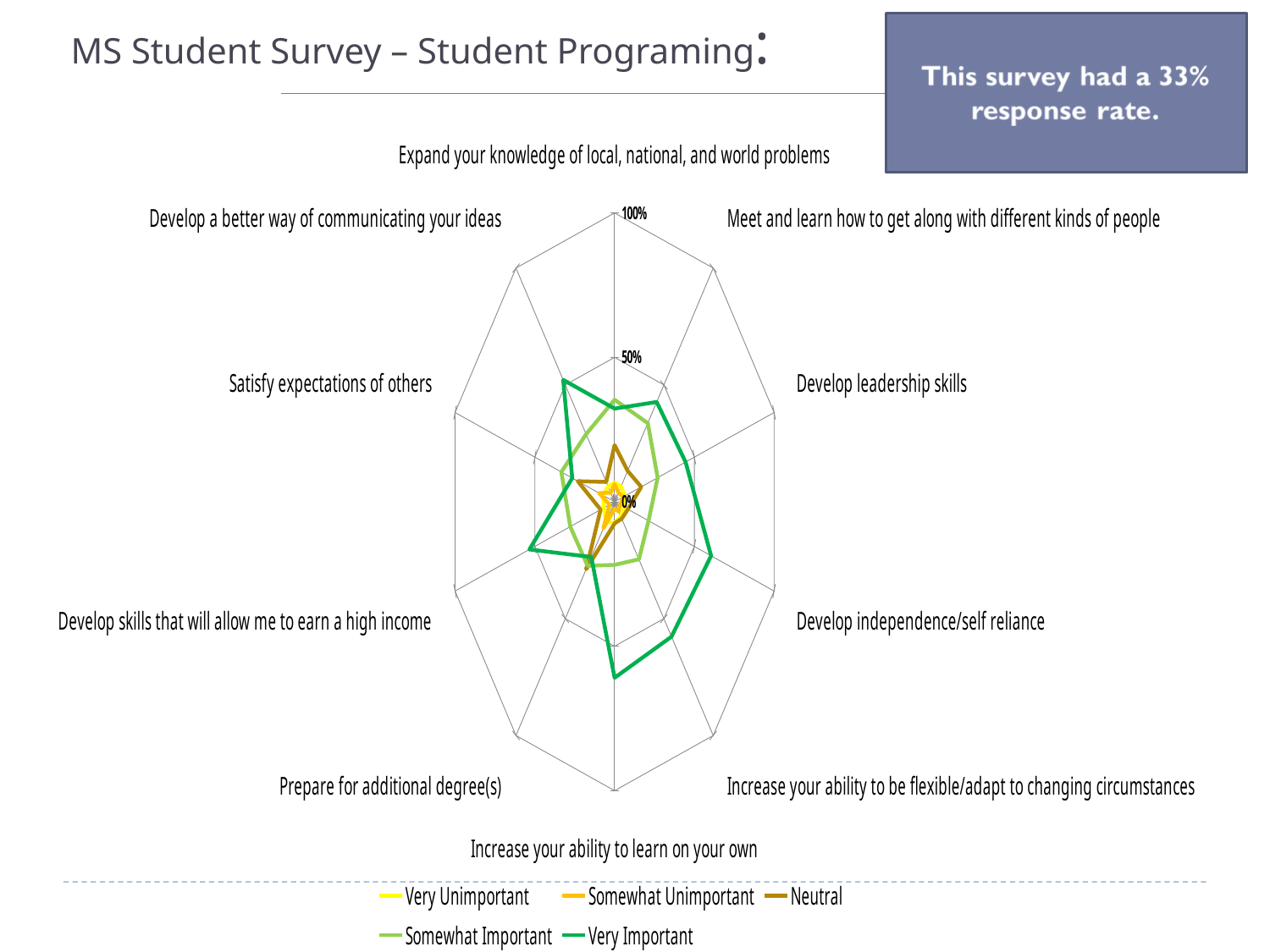
Is the Very Important value for "Increase your ability to learn on your own" greater or less than 50%? greater Is the Neutral value for "Expand your knowledge of local, national, and world problems" greater or less than 50%? less For the Very Important series, which is larger: "Increase your ability to learn on your own" or "Expand your knowledge of local, national, and world problems"? Increase your ability to learn on your own Is the Very Important value for "Expand your knowledge of local, national, and world problems" greater or less than 50%? less What kind of chart is shown on the slide? Radar chart How many categories (axes) does the radar chart have? 10 Which series is drawn in dark green on the radar chart? Very Important What is the highest percentage tick shown on the radar chart's axis? 100% How many series does the legend list? 5